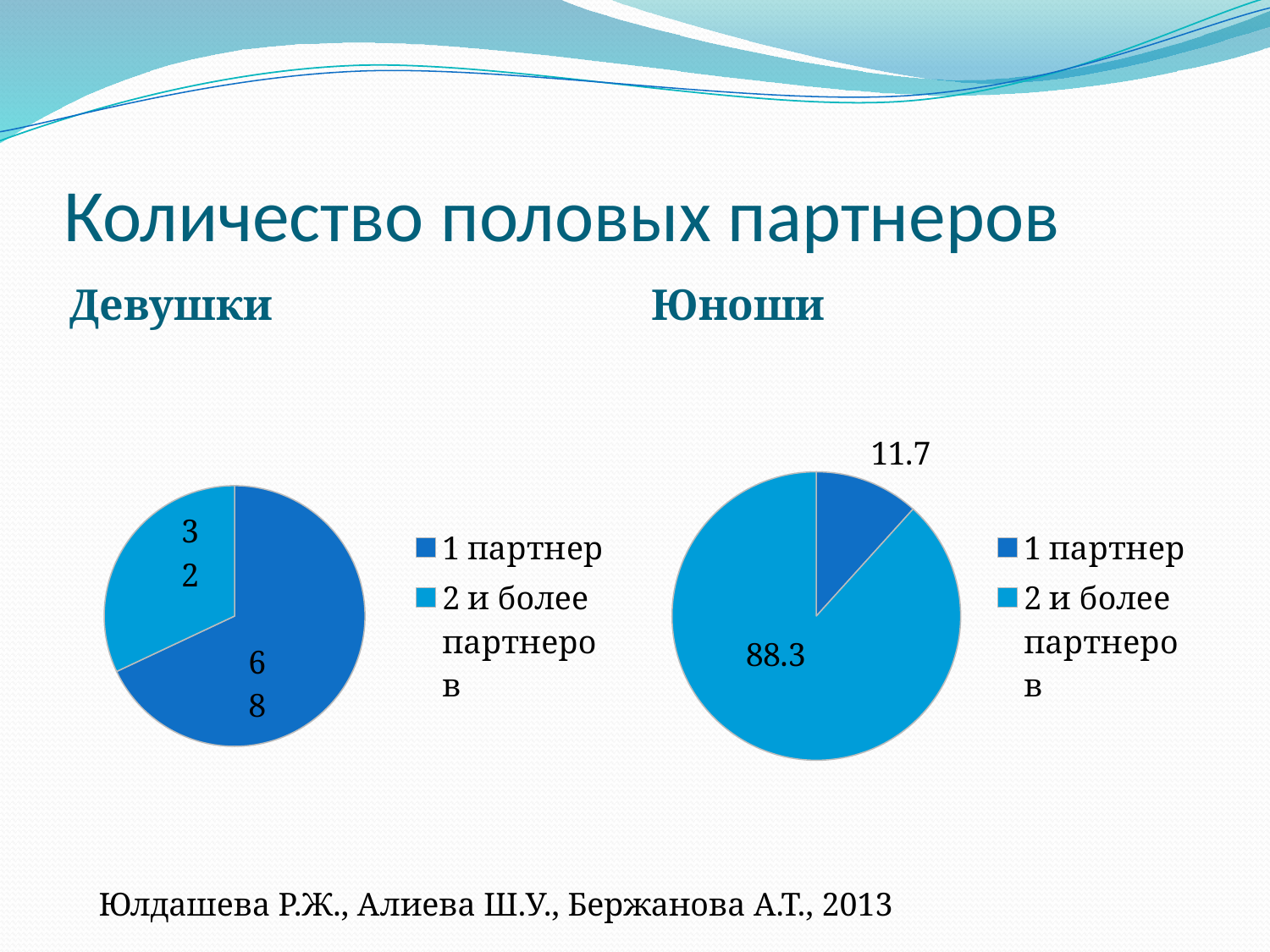
In the Девушки pie chart, what is the value for 1 партнер? 68 What is the title of the slide? Количество половых партнеров What type of chart is used on this slide? Pie chart How many categories does the legend of the Юноши chart list? 2 In the Юноши pie chart, what is the value for 1 партнер? 11.7 Which is larger: the 1 партнер value in the Девушки chart or the 1 партнер value in the Юноши chart? Девушки In the Девушки chart, which category has the largest slice? 1 партнер In the Юноши chart, what is the difference between the 2 и более партнеров value and the 1 партнер value? 76.6 In the Девушки pie chart, what is the value for 2 и более партнеров? 32 In the Юноши chart, which category has the smallest slice? 1 партнер In the Девушки chart, what is the difference between the 1 партнер value and the 2 и более партнеров value? 36 In the Юноши pie chart, what is the value for 2 и более партнеров? 88.3